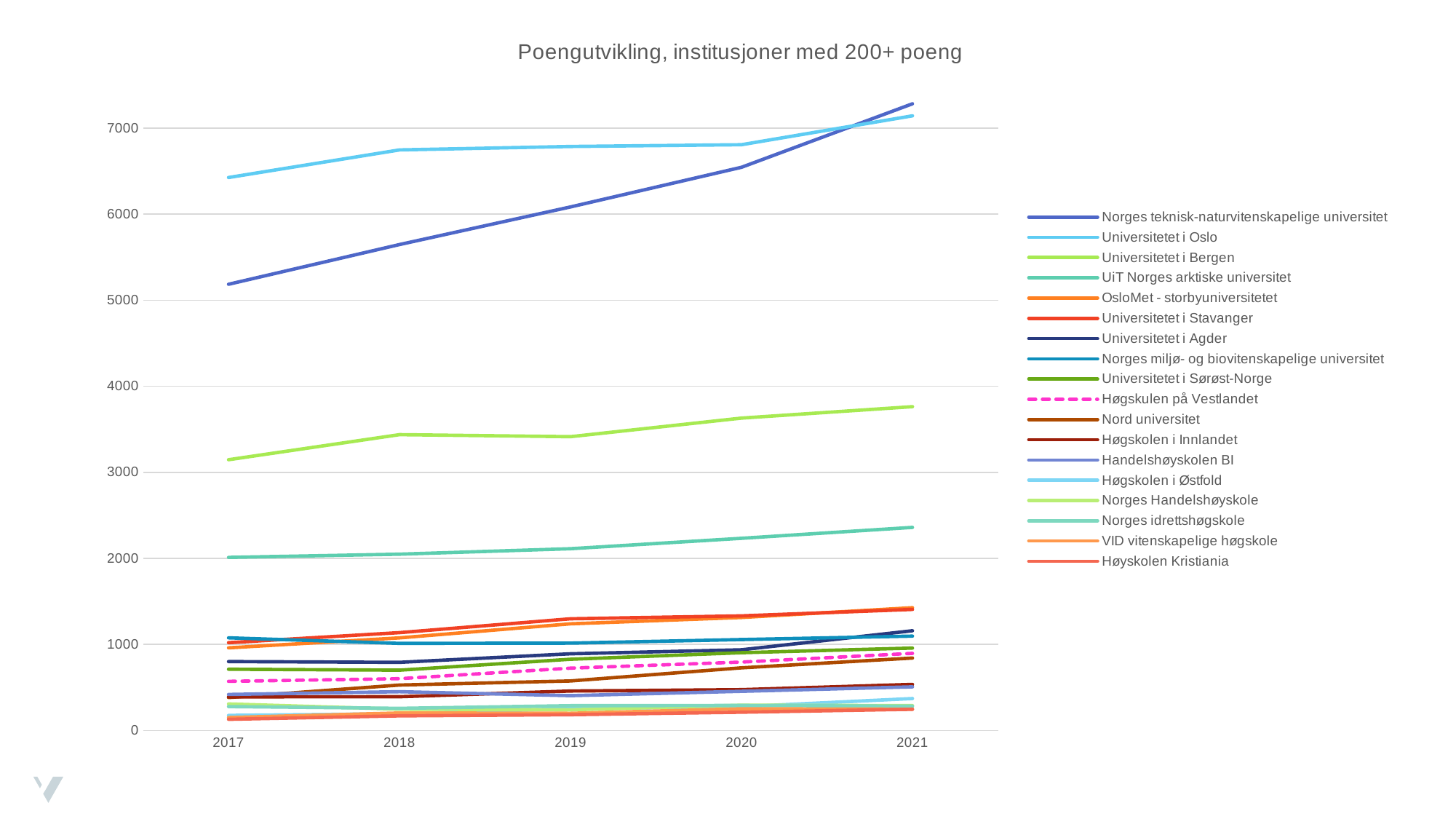
Is the value for Norges teknisk-naturvitenskapelige universitet in 2017 greater or less than 5000? greater What kind of chart is shown on the slide? line chart What is the title of the chart? Poengutvikling, institusjoner med 200+ poeng Do the values for Norges teknisk-naturvitenskapelige universitet rise or fall from 2017 to 2021? rise How many series does the legend list? 18 Is the value for Universitetet i Bergen in 2021 greater or less than 4000? less Which institution has the highest value in 2021? Norges teknisk-naturvitenskapelige universitet Is the value for Universitetet i Oslo in 2017 greater or less than 6000? greater Which series is drawn with a dashed line? Høgskulen på Vestlandet In 2017, which is larger: Universitetet i Oslo or Norges teknisk-naturvitenskapelige universitet? Universitetet i Oslo How many years are shown on the x axis? 5